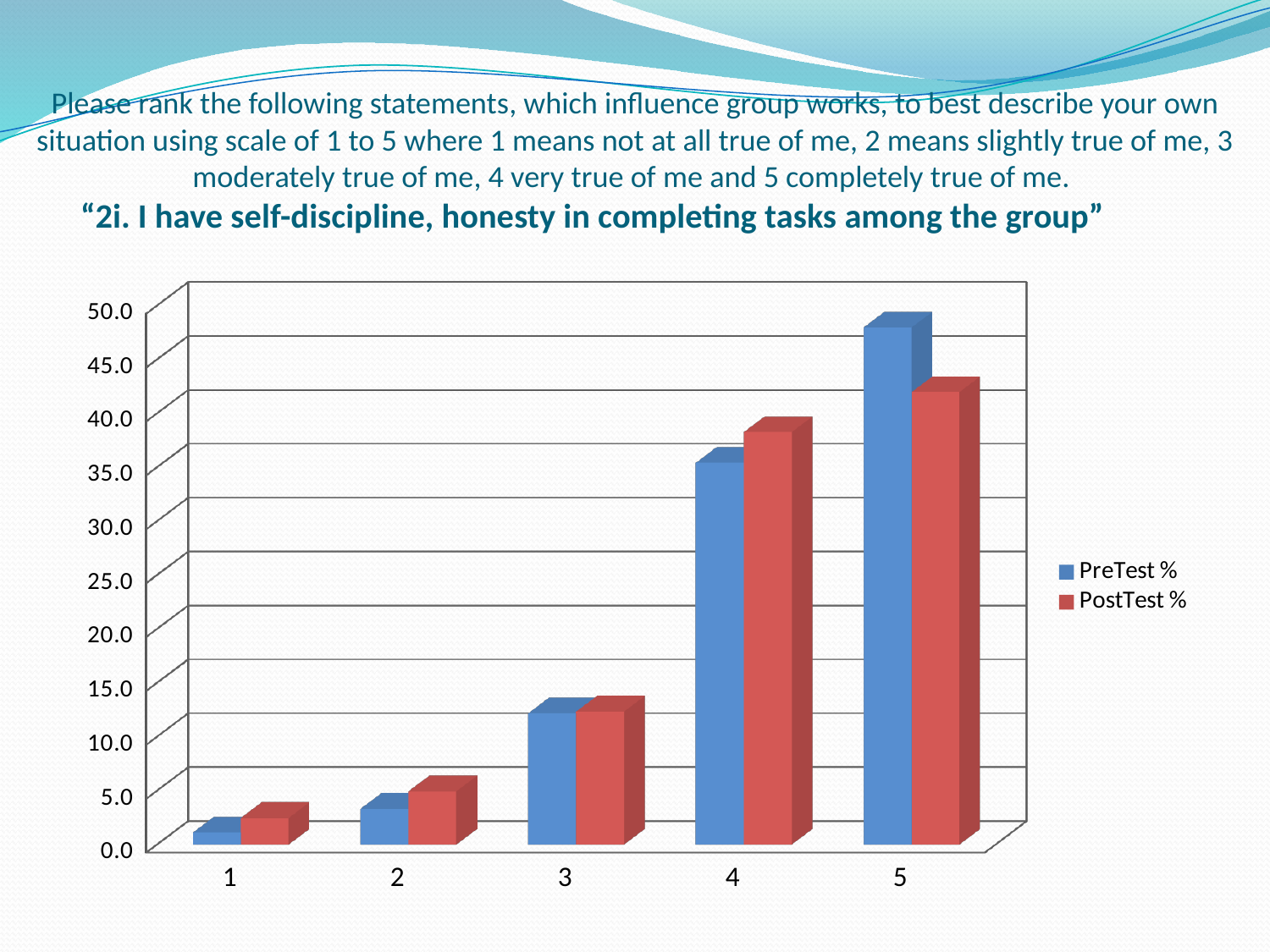
How many categories are shown on the x axis? 5 What kind of chart is shown on the slide? bar chart Is the PreTest % value for category 4 greater or less than 30.0? greater Is the PostTest % value for category 5 greater or less than 45.0? less Do the PreTest % values rise or fall from category 1 to category 5? rise Is the PostTest % value for category 2 greater or less than 10.0? less For category 5, which series has the larger value, PreTest % or PostTest %? PreTest % For category 4, which series has the larger value, PreTest % or PostTest %? PostTest % Which category has the lowest PreTest % value? 1 How many series does the legend list? 2 Which category has the highest PreTest % value? 5